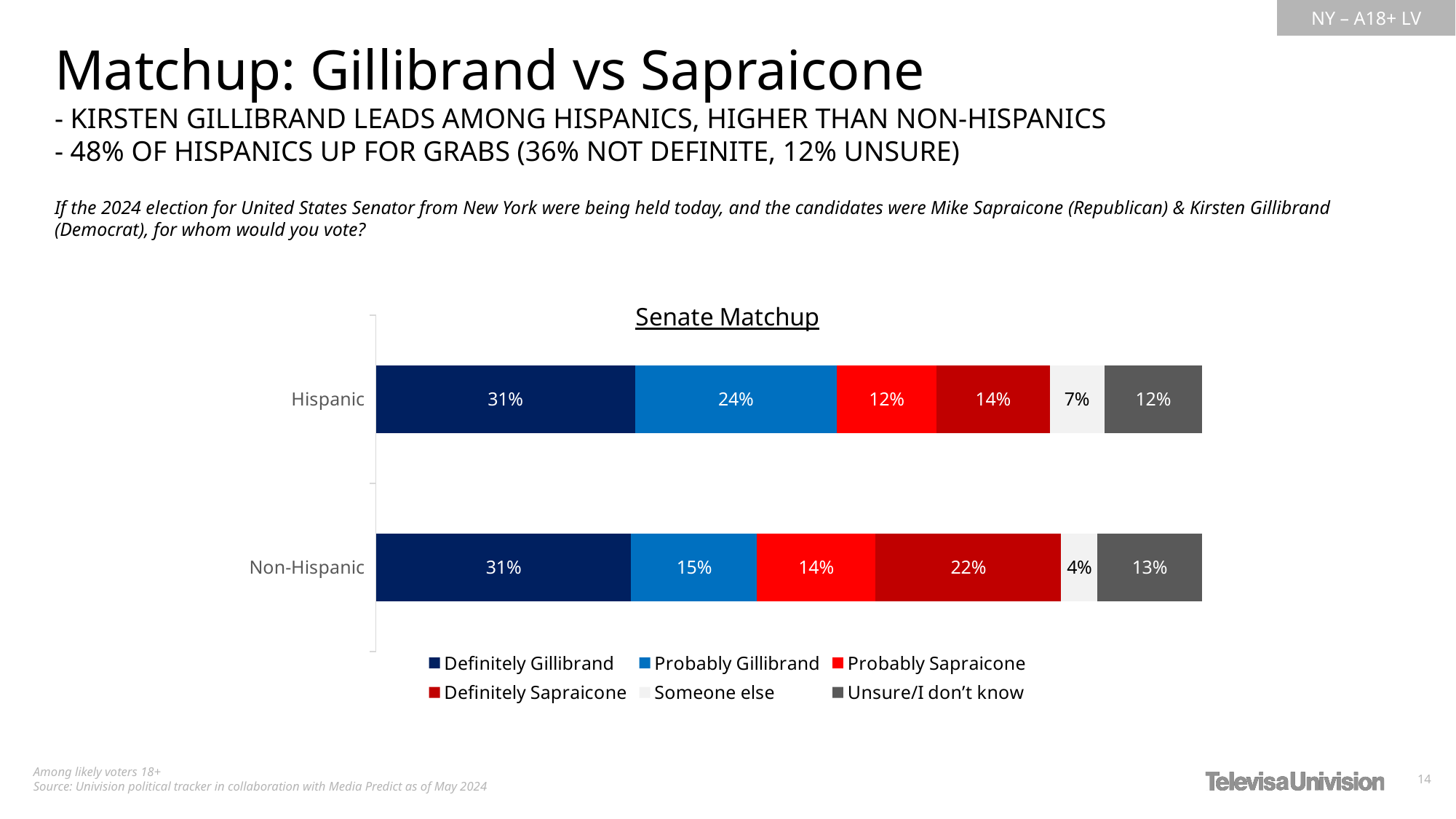
What is the value for Someone else among Non-Hispanic voters? 4% How many series does the legend list? 6 What type of chart is shown? Stacked bar chart What is the value for Probably Gillibrand among Non-Hispanic voters? 15% What is the difference between the Definitely Sapraicone values for Non-Hispanic and Hispanic voters? 8% How many categories (groups) are shown on the chart? 2 What is the value for Unsure/I don't know among Hispanic voters? 12% What is the value for Definitely Sapraicone among Hispanic voters? 14% Which segment is the smallest in the Hispanic bar? Someone else What is the value for Definitely Gillibrand among Hispanic voters? 31% Which group has the larger Probably Gillibrand value, Hispanic or Non-Hispanic? Hispanic Which segment is the largest in the Non-Hispanic bar? Definitely Gillibrand